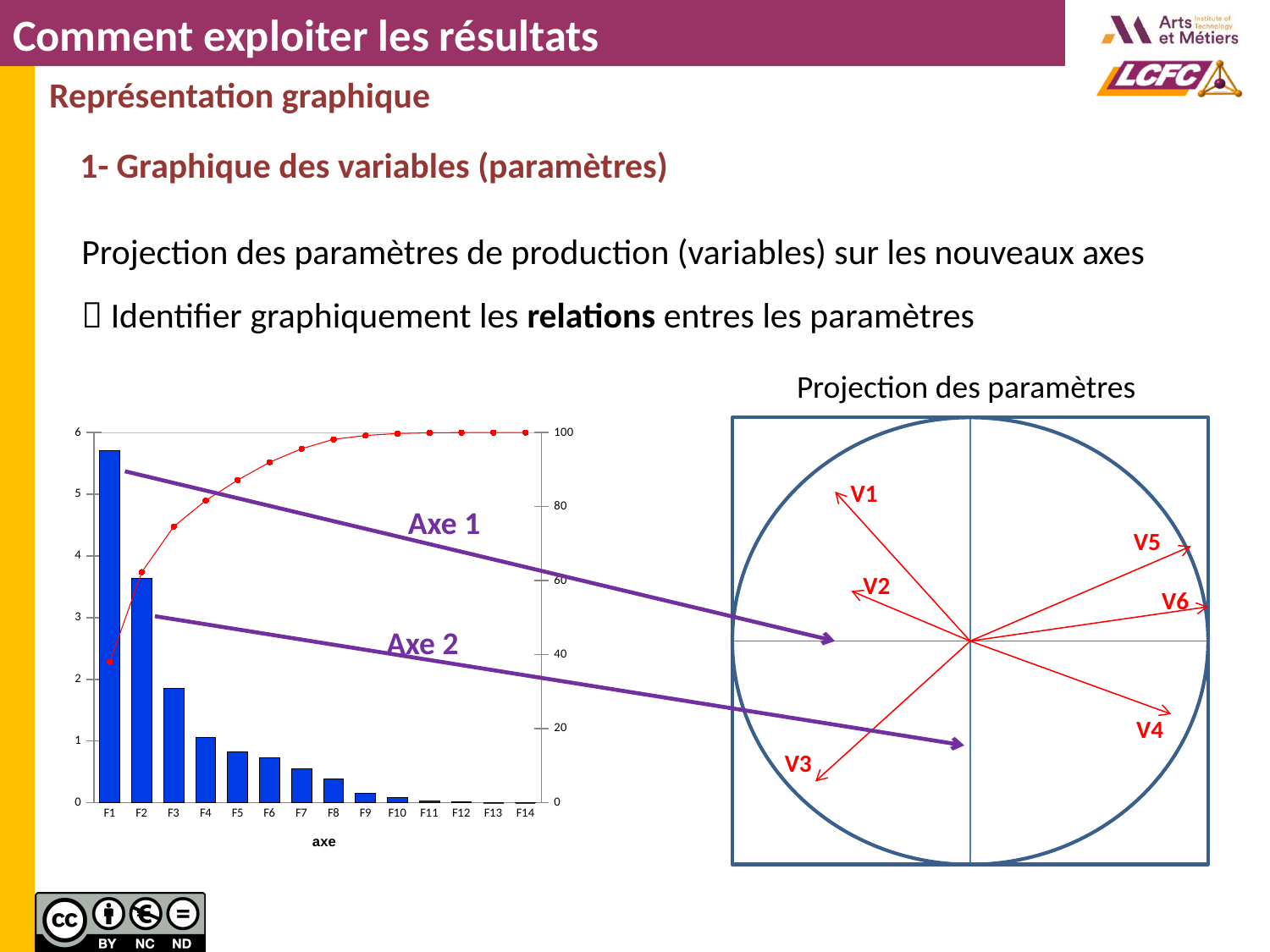
In the chart on the left, is the bar for F3 greater or less than 2 on the left axis? less In the chart on the left, what kind of chart is used to show the values for F1 to F14? bar chart (with a line overlay) In the chart on the left, what is the title of the x axis? axe In the chart on the left, is the bar for F1 greater or less than 5 on the left axis? greater In the chart on the left, does the red line rise or fall from F1 to F14? rise In the chart on the left, which bar is taller, F1 or F2? F1 In the 'Projection des paramètres' diagram on the right, how many labelled variable arrows are shown? 6 In the chart on the left, is the bar for F2 greater or less than 4 on the left axis? less In the chart on the left, do the bar values rise or fall from F1 to F14? fall In the chart on the left, which category has the tallest bar? F1 In the chart on the left, how many categories are shown on the x axis? 14